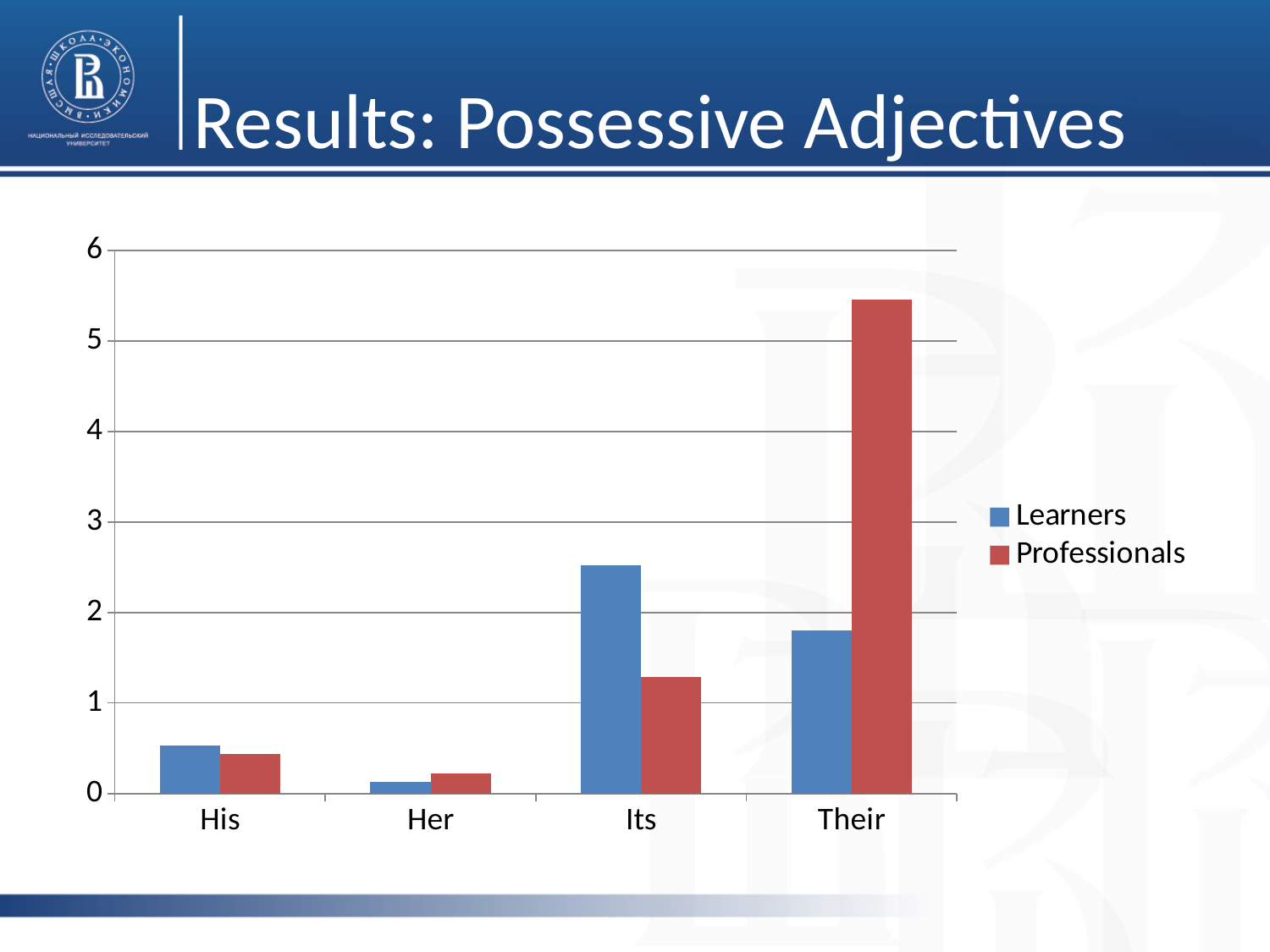
Is the value for Learners in the Its category greater or less than 2? greater Is the value for Professionals in the Their category greater or less than 5? greater Which category has the lowest value for Professionals? Her Which category has the highest value for Learners? Its What are the two series named in the chart's legend? Learners and Professionals How many series does the chart's legend list? 2 What kind of chart is shown on the slide? bar chart How many categories are shown on the x axis of the chart? 4 For the Its category, which series has the larger value, Learners or Professionals? Learners Which category has the highest value for Professionals? Their Which category has the lowest value for Learners? Her Is the value for Learners in the Their category greater or less than 2? less